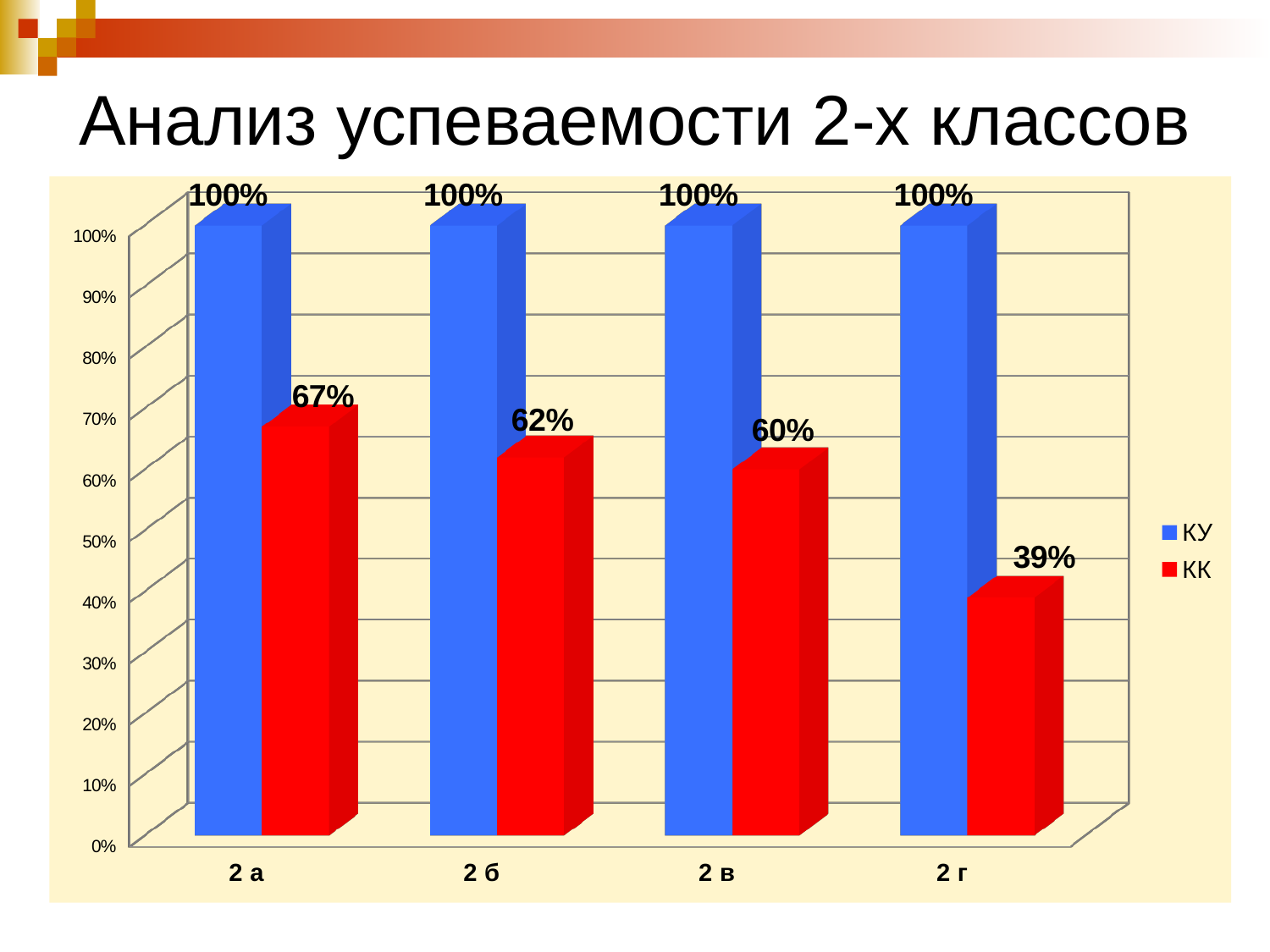
Which is larger, the КК value for 2 б or for 2 в? 2 б Do the КК values rise or fall from 2 а to 2 г? Fall What is the КК value for class 2 г? 39% Which class has the lowest КК value? 2 г What kind of chart is shown on the slide? Bar chart Which class has the highest КК value? 2 а How many series does the legend list? 2 What is the difference between the КК values for 2 а and 2 г? 28% What is the КУ value for class 2 б? 100% What is the КК value for class 2 а? 67% How many classes are shown on the x axis? 4 What is the КК value for class 2 в? 60%